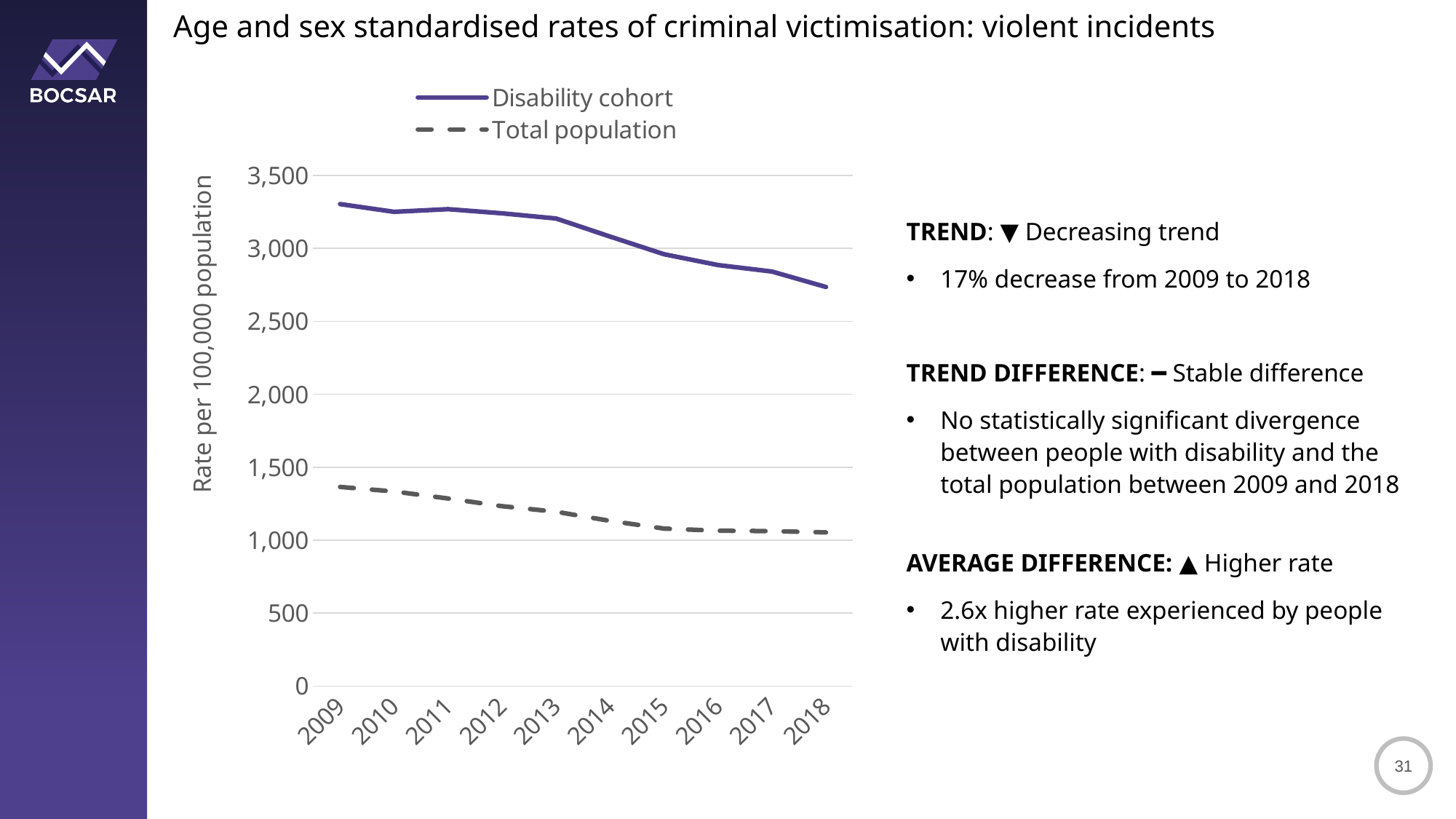
Is the Total population value for 2018 greater or less than 1,000? greater What is the label of the y axis? Rate per 100,000 population Is the Total population value for 2009 greater or less than 1,500? less Is the Disability cohort value for 2018 greater or less than 3,000? less What kind of chart is shown on the slide? line chart Does the Disability cohort rate rise or fall from 2009 to 2018? fall Which series has the higher rate in 2018, Disability cohort or Total population? Disability cohort In which year is the Disability cohort rate lowest? 2018 Does the Total population rate rise or fall from 2009 to 2018? fall How many years are plotted along the x axis? 10 How many series does the legend list? 2